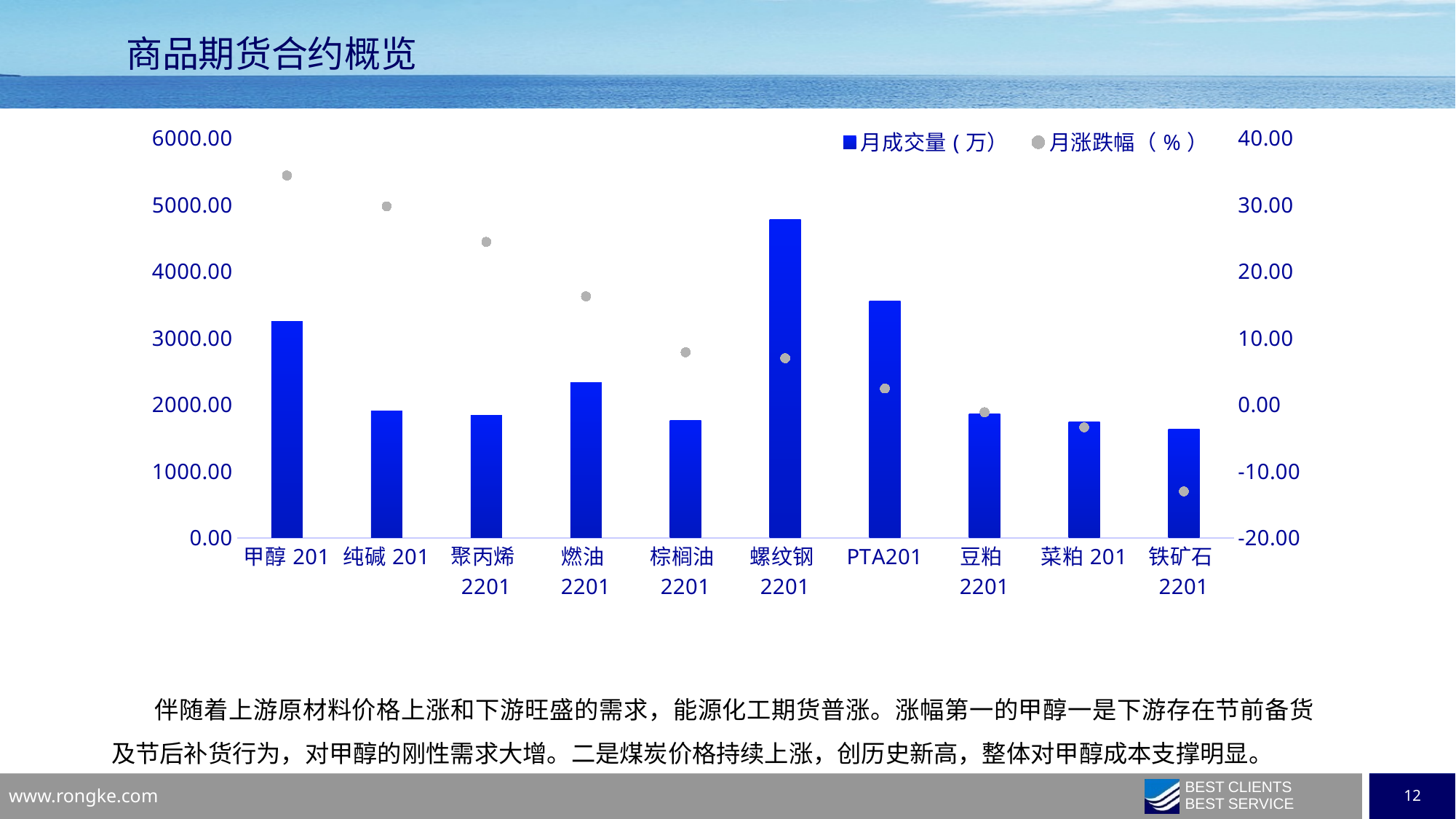
Which category has the lowest 月涨跌幅 (%) marker? 铁矿石 2201 Is the 月成交量 (万) value for 螺纹钢 2201 greater or less than 4000? greater Is the 月涨跌幅 (%) value for 铁矿石 2201 greater or less than -10? less Which has the larger 月成交量 (万) bar, 甲醇 201 or PTA201? PTA201 Is the 月成交量 (万) value for 纯碱 201 greater or less than 2000? less How many categories are shown on the x axis of the chart? 10 Which category has the highest 月成交量 (万) bar? 螺纹钢 2201 What are the two series names listed in the chart legend? 月成交量（万）and 月涨跌幅（%） How many series does the chart legend list? 2 Which category has the highest 月涨跌幅 (%) marker? 甲醇 201 Do the 月涨跌幅 (%) markers generally rise or fall from left to right along the x axis? fall